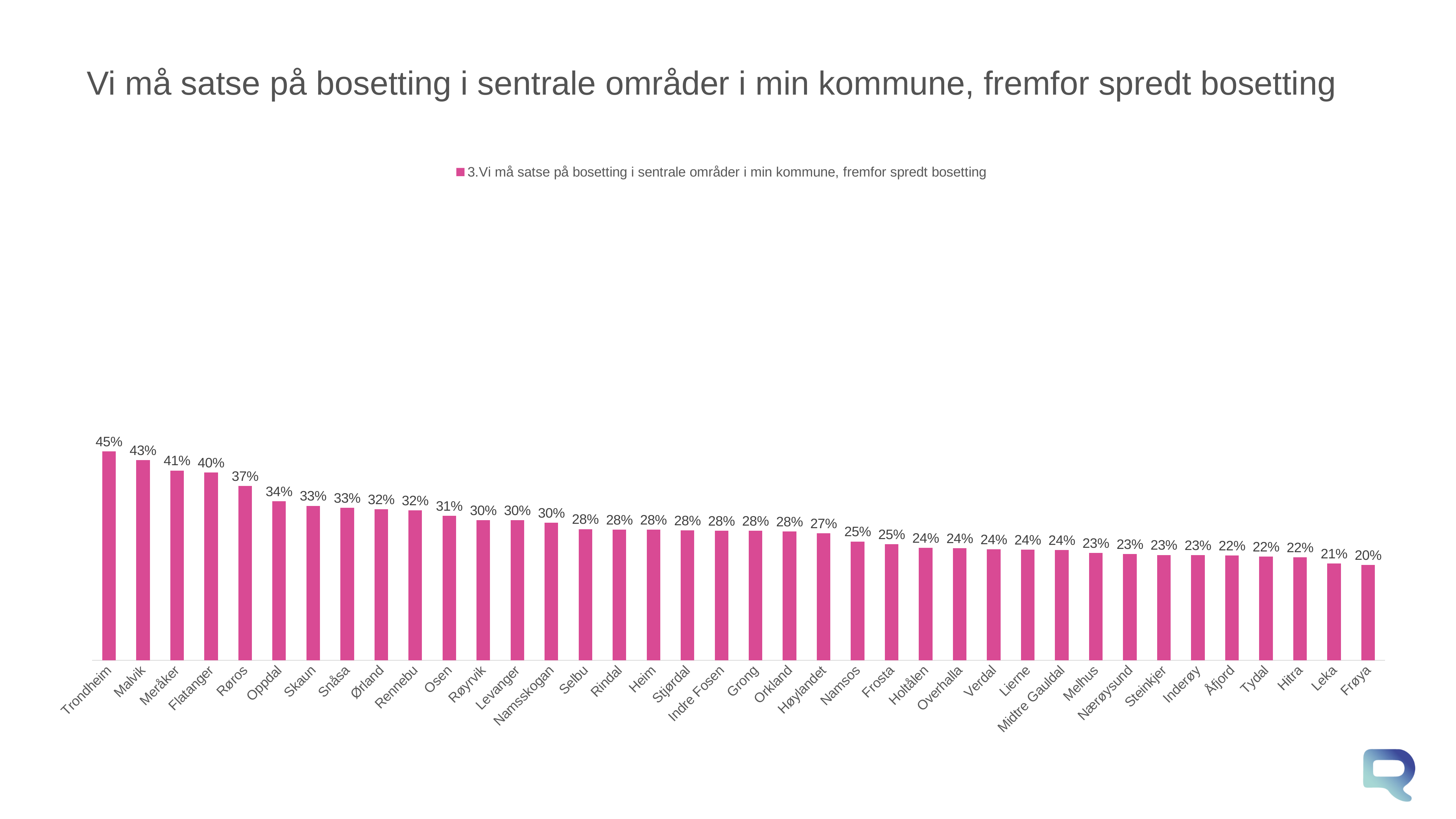
What is the value for Frøya? 20% What is the value for Røros? 37% What kind of chart is shown on the slide? Bar chart What is the difference between the values for Trondheim and Malvik? 2% What is the value for Trondheim? 45% Which has a larger value, Flatanger or Namsos? Flatanger Which municipality has the lowest value? Frøya Do the values rise or fall from left to right along the x axis? Fall What is the difference between the values for Oppdal and Leka? 13% What is the value for Stjørdal? 28% How many municipalities are shown on the x axis? 38 Which municipality has the highest value? Trondheim